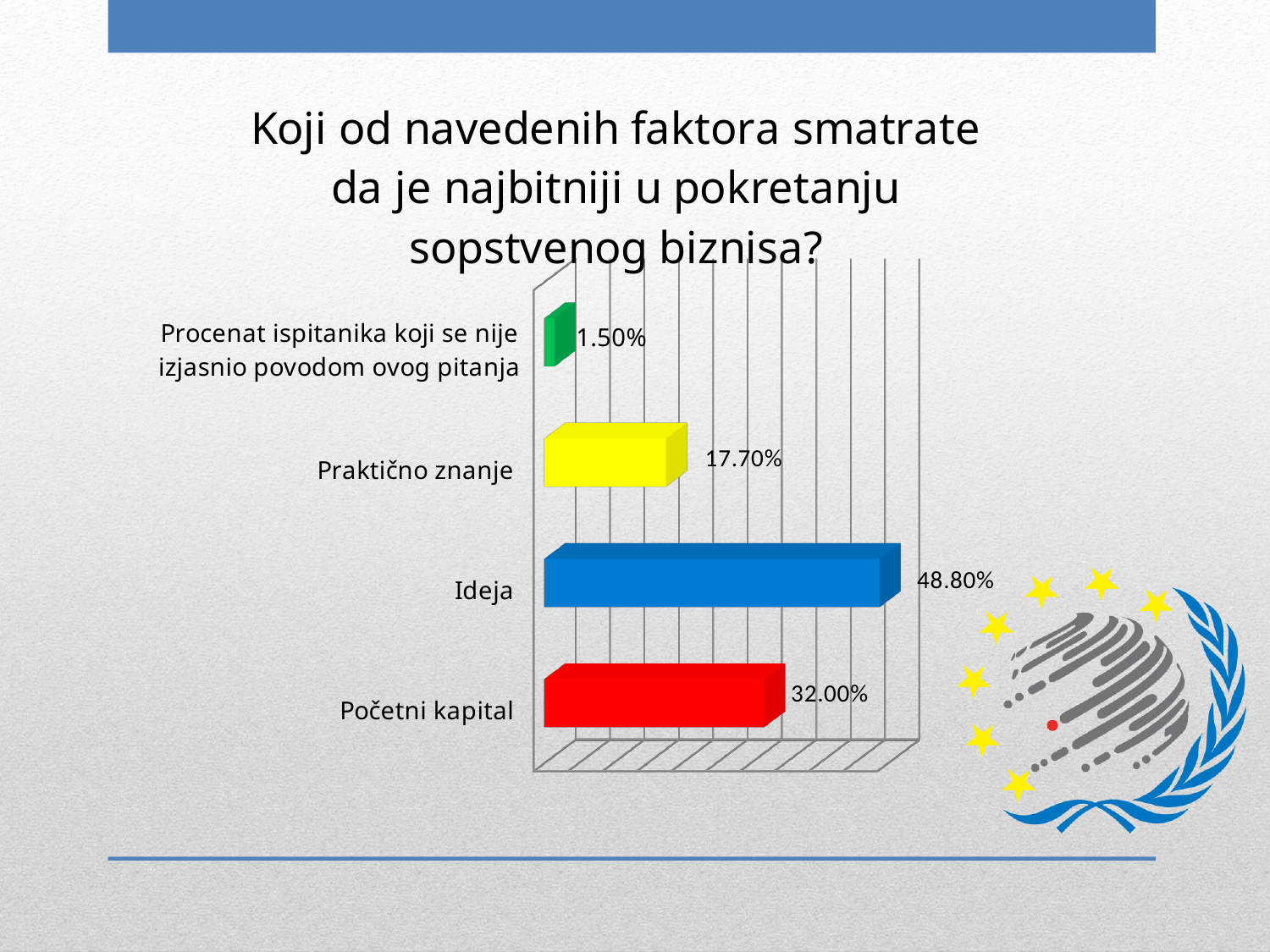
What kind of chart is shown on the slide? Bar chart What colour is the bar for Ideja? Blue Which category has the highest value? Ideja What is the value for Ideja? 48.80% How many categories are shown in the chart? 4 Which category has the lowest value? Procenat ispitanika koji se nije izjasnio povodom ovog pitanja What is the value for Početni kapital? 32.00% What is the difference between the values for Ideja and Početni kapital? 16.80% Which is larger, the value for Praktično znanje or the value for Početni kapital? Početni kapital What is the value for Praktično znanje? 17.70% What is the difference between the values for Početni kapital and Praktično znanje? 14.30% What is the value for 'Procenat ispitanika koji se nije izjasnio povodom ovog pitanja'? 1.50%